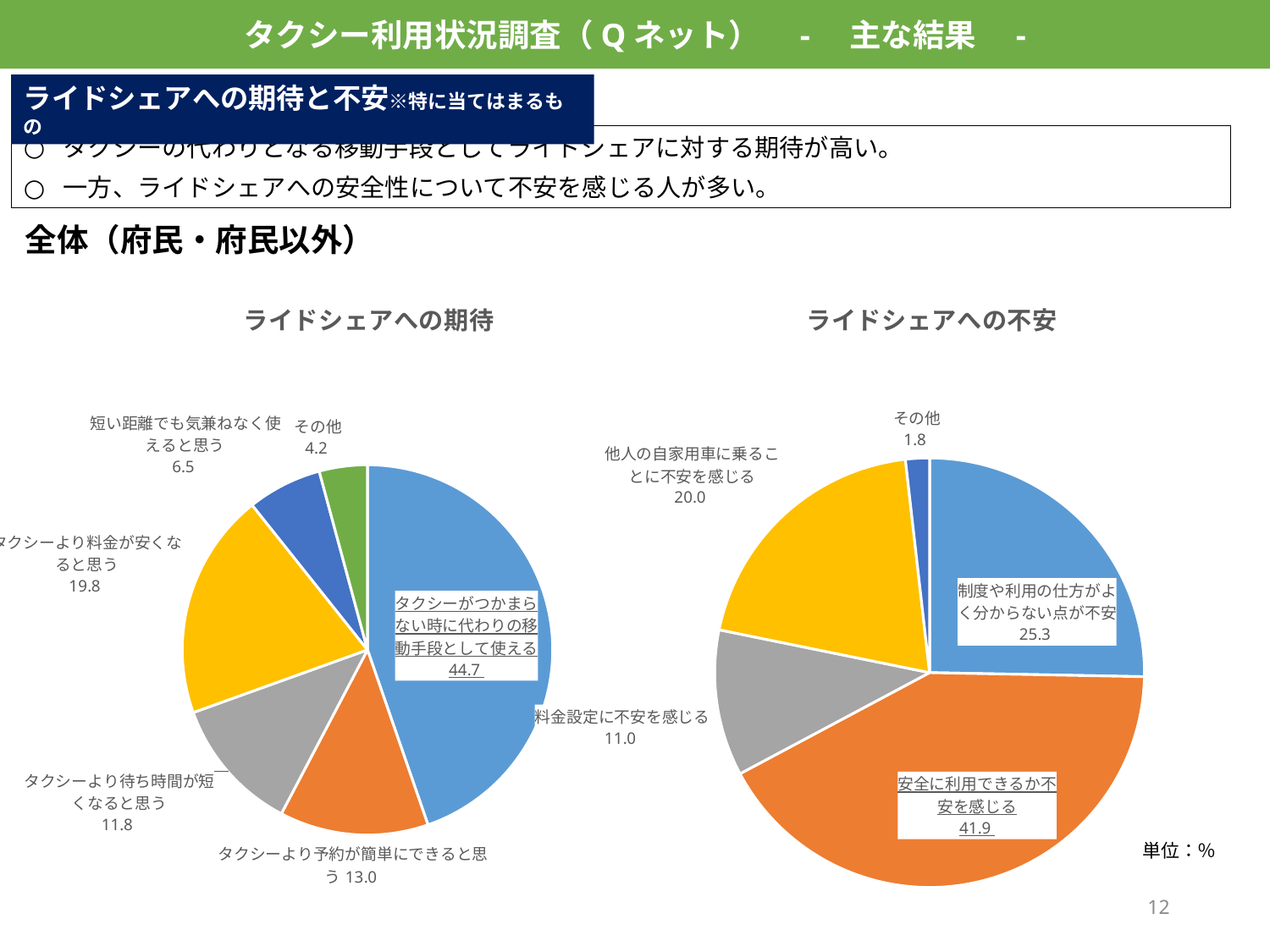
What kind of chart is the 「ライドシェアへの期待」 chart on the left? pie chart In the 「ライドシェアへの期待」 chart, what is the value for 「タクシーがつかまらない時に代わりの移動手段として使える」? 44.7 In the 「ライドシェアへの不安」 chart, which is larger: 「制度や利用の仕方がよく分からない点が不安」 or 「料金設定に不安を感じる」? 制度や利用の仕方がよく分からない点が不安 What unit is indicated for the values in the charts on this slide? % In the 「ライドシェアへの不安」 chart, which category has the largest slice? 安全に利用できるか不安を感じる In the 「ライドシェアへの期待」 chart, what is the value for 「タクシーより予約が簡単にできると思う」? 13.0 In the 「ライドシェアへの期待」 chart, which category has the smallest slice? その他 In the 「ライドシェアへの不安」 chart, what is the value for 「他人の自家用車に乗ることに不安を感じる」? 20.0 In the 「ライドシェアへの期待」 chart, how many slices are there? 6 In the 「ライドシェアへの不安」 chart, how many slices are there? 5 In the 「ライドシェアへの期待」 chart, what is the difference between 「タクシーより料金が安くなると思う」 and 「タクシーより待ち時間が短くなると思う」? 8.0 In the 「ライドシェアへの不安」 chart, what is the value for 「安全に利用できるか不安を感じる」? 41.9